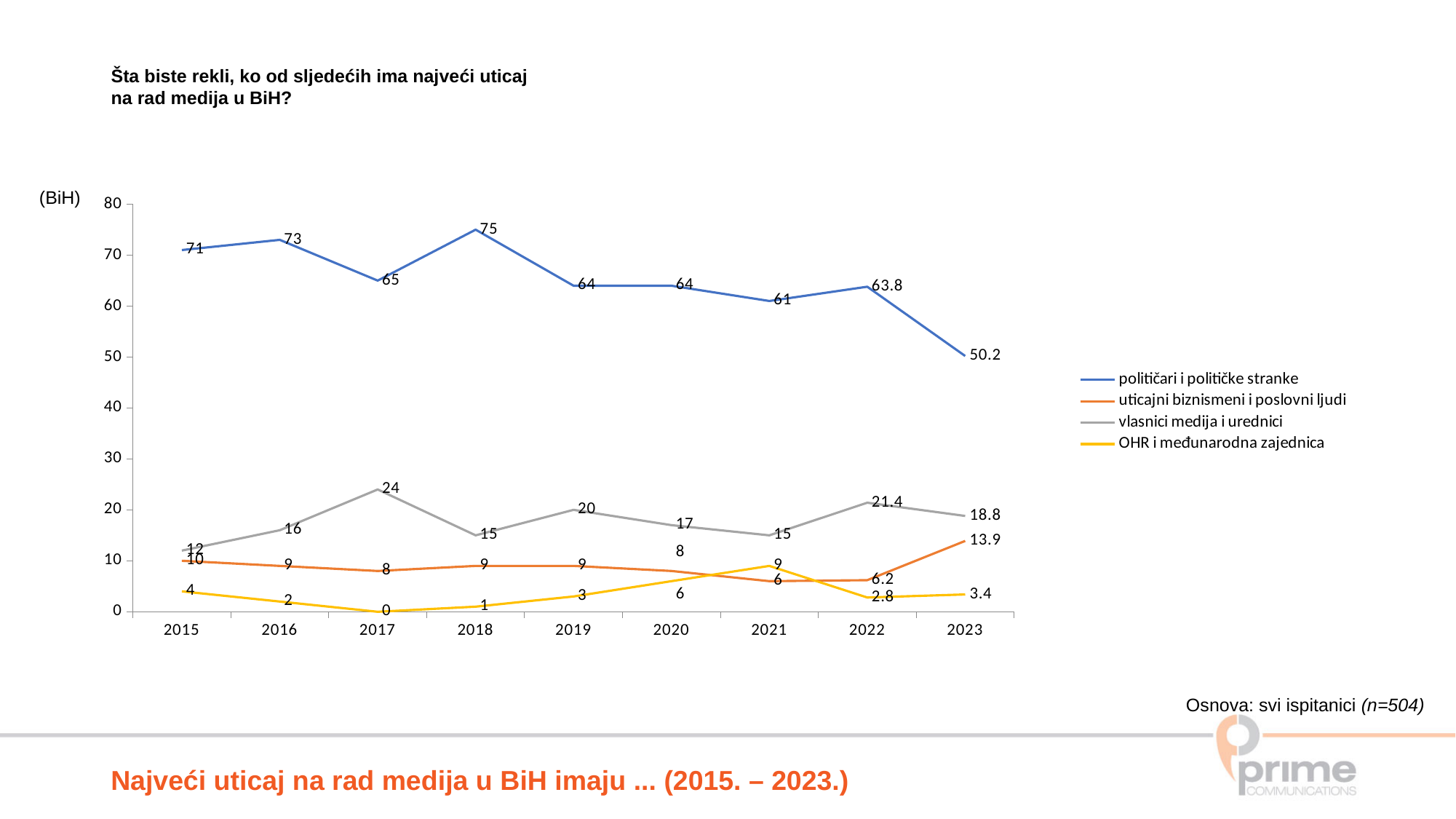
How many years are plotted along the x axis? 9 What type of chart is shown on the slide? line chart What is the value for 'uticajni biznismeni i poslovni ljudi' in 2023? 13.9 What is the value for 'političari i političke stranke' in 2023? 50.2 What is the value for 'OHR i međunarodna zajednica' in 2021? 9 Which series is shown in yellow in the legend? OHR i međunarodna zajednica Which series has the higher value in 2021: 'uticajni biznismeni i poslovni ljudi' or 'OHR i međunarodna zajednica'? OHR i međunarodna zajednica In which year does 'političari i političke stranke' reach its highest value? 2018 In which year does 'OHR i međunarodna zajednica' have its lowest value? 2017 What is the difference between the 'političari i političke stranke' values in 2022 and 2023? 13.6 What is the value for 'vlasnici medija i urednici' in 2017? 24 How many series does the legend list? 4